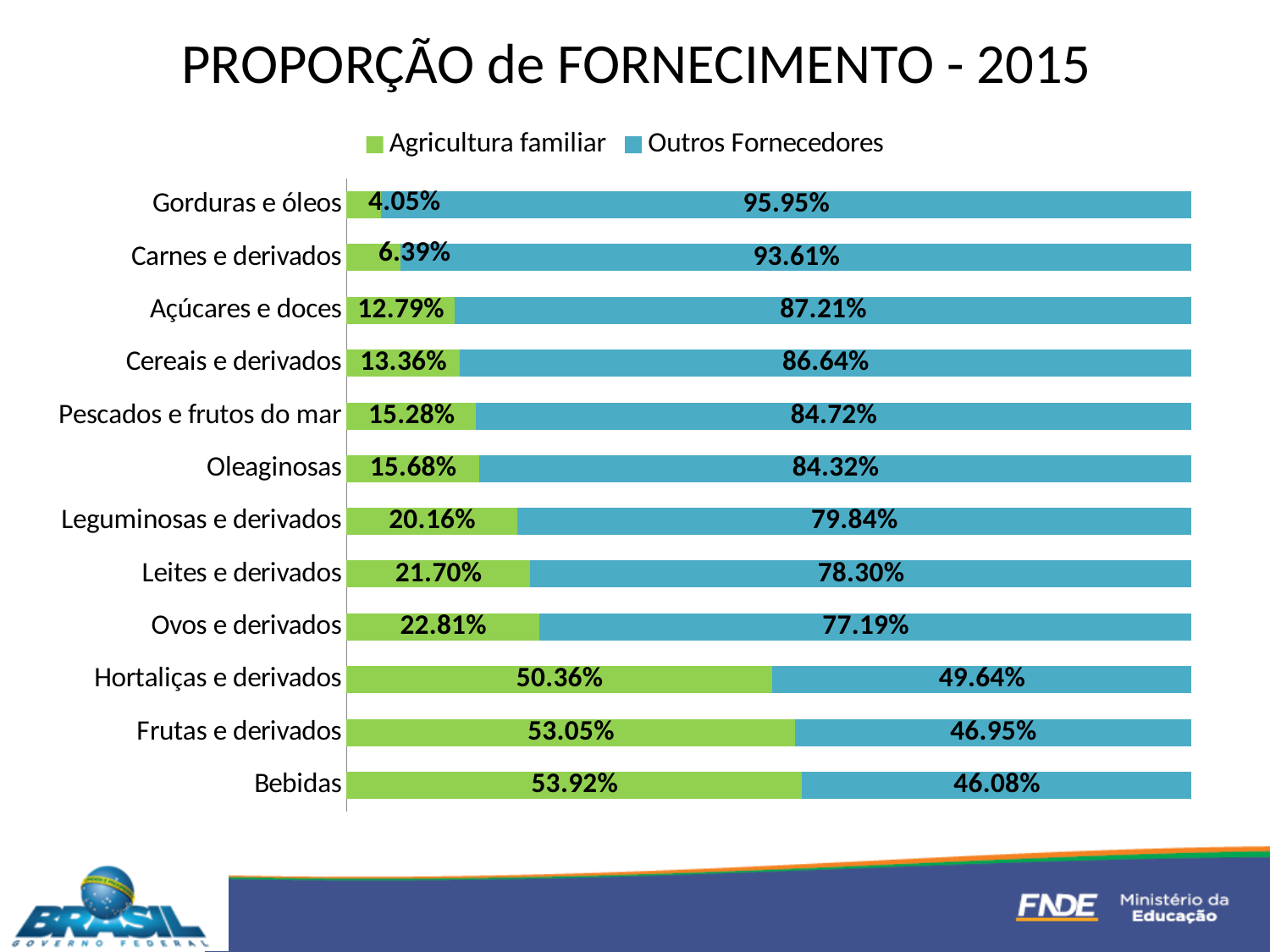
What is the difference between the Outros Fornecedores and Agricultura familiar values for Ovos e derivados? 54.38% How many series does the legend list? 2 Which category has the lowest Agricultura familiar share? Gorduras e óleos What kind of chart is shown on the slide? Stacked bar chart How many categories are shown in the chart? 12 What is the title of the chart? PROPORÇÃO de FORNECIMENTO - 2015 Which category has the highest Agricultura familiar share? Bebidas What is the Agricultura familiar value for Leites e derivados? 21.70% Which has a larger Agricultura familiar value, Hortaliças e derivados or Frutas e derivados? Frutas e derivados What is the Outros Fornecedores value for Oleaginosas? 84.32% What is the total of the stacked bar for Gorduras e óleos? 100% What is the Agricultura familiar value for Pescados e frutos do mar? 15.28%